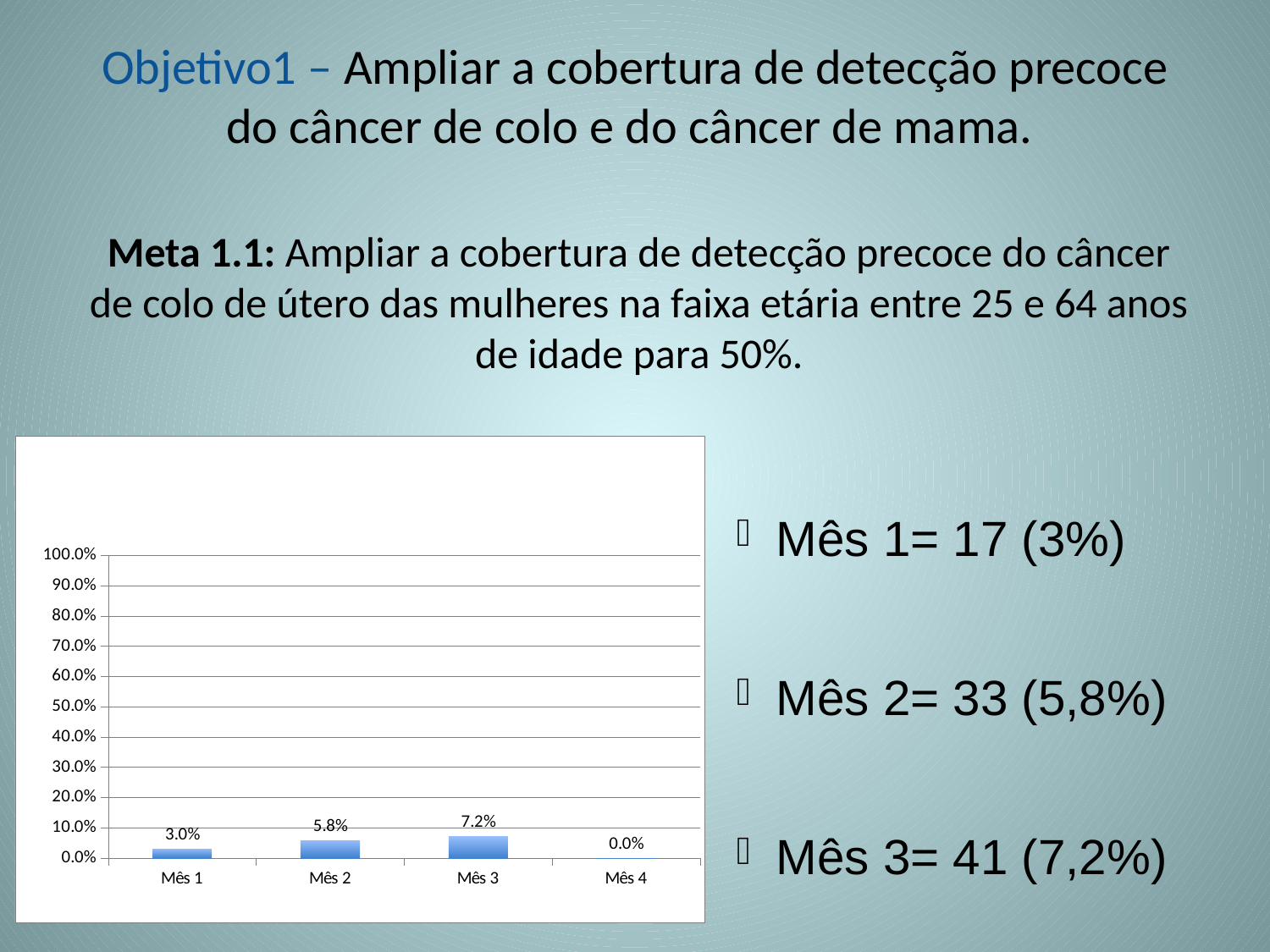
Which month has the highest value? Mês 3 Which is larger, the value for Mês 2 or the value for Mês 3? Mês 3 What kind of chart is shown on the slide? bar chart What is the difference between the values for Mês 3 and Mês 1? 4.2% What is the value for Mês 1? 3.0% How many categories are shown on the x axis? 4 What is the value for Mês 4? 0.0% Which month has the lowest value? Mês 4 Is the value for Mês 3 greater or less than 10.0%? less What is the value for Mês 3? 7.2% What is the value for Mês 2? 5.8% What is the difference between the values for Mês 2 and Mês 1? 2.8%